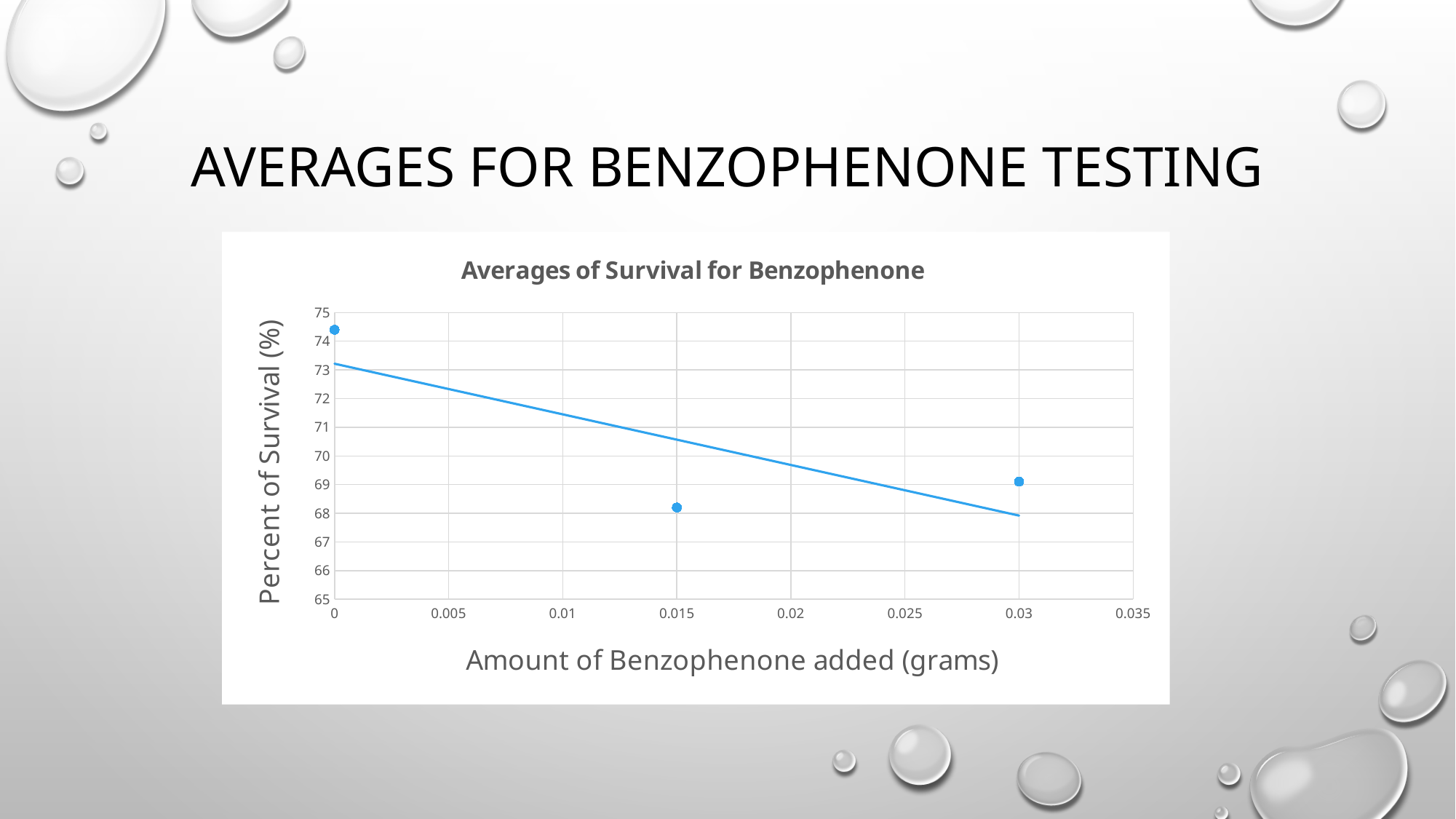
What kind of chart is shown on the slide? scatter chart What is the label of the x axis? Amount of Benzophenone added (grams) Which has a higher percent of survival: 0 grams or 0.03 grams of benzophenone added? 0 grams Is the percent of survival at 0 grams greater or less than 73? greater Is the percent of survival at 0.015 grams greater or less than 69? less At which amount of benzophenone added is the percent of survival highest? 0 How many data points are plotted on the chart? 3 Does the trend line rise or fall as the amount of benzophenone added increases? fall At which amount of benzophenone added is the percent of survival lowest? 0.015 What is the title of the chart? Averages of Survival for Benzophenone Is the percent of survival at 0.03 grams greater or less than 70? less